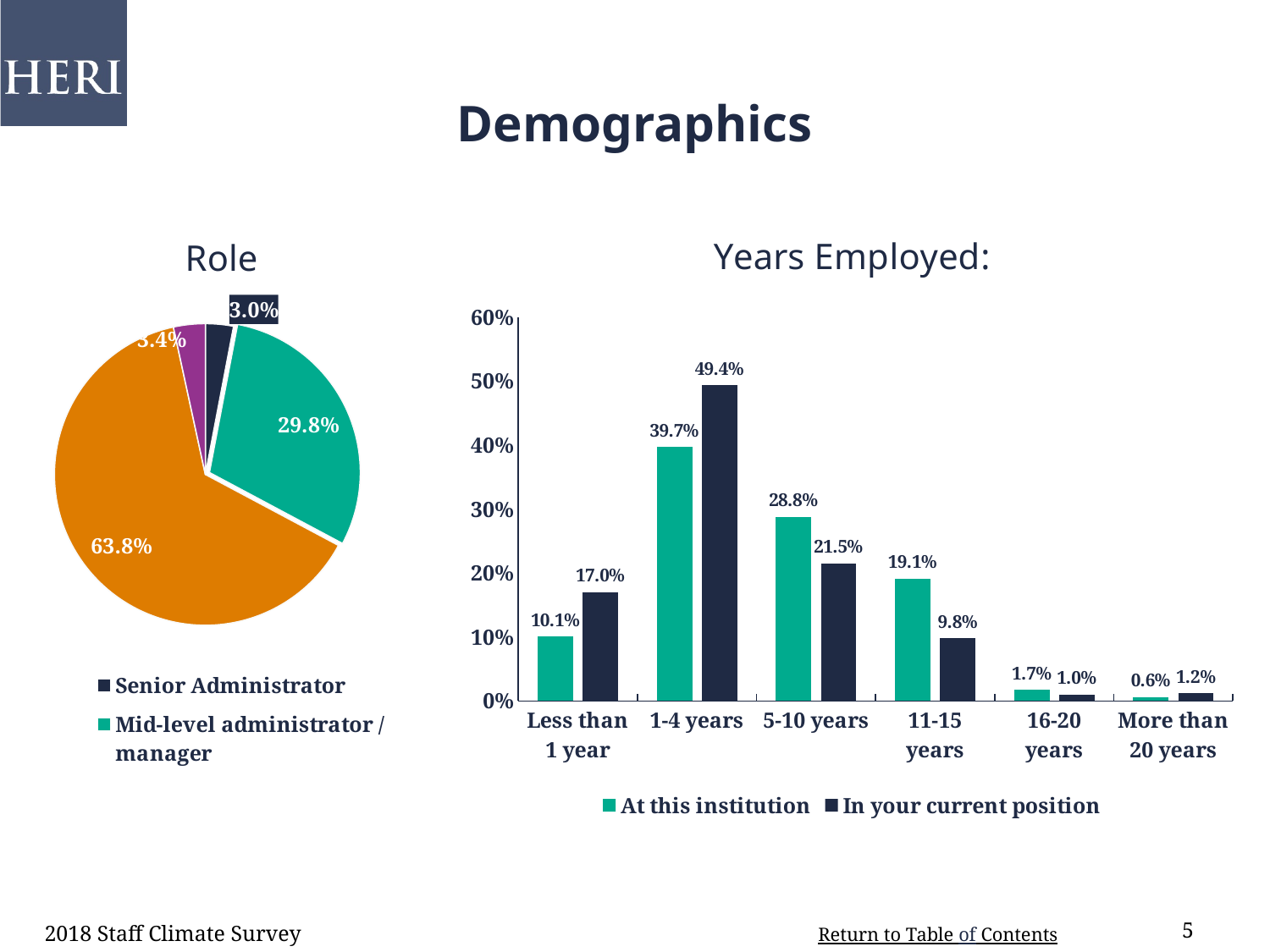
In the Role chart, what share is shown for Mid-level administrator / manager? 29.8% What kind of chart is the Years Employed chart? Bar chart What kind of chart is the Role chart? Pie chart How many categories are shown on the x axis of the Years Employed chart? 6 In the Years Employed chart, for Less than 1 year, which series has the larger value? In your current position How many series does the legend of the Years Employed chart list? 2 In the Years Employed chart, which category has the highest value for In your current position? 1-4 years In the Role chart, what share is shown for Senior Administrator? 3.0% In the Years Employed chart, how much higher is the In your current position value than the At this institution value for 1-4 years? 9.7 percentage points In the Years Employed chart, what percentage is shown for 5-10 years in the In your current position series? 21.5% In the Years Employed chart, what percentage is shown for 1-4 years in the At this institution series? 39.7% In the Years Employed chart, which category has the lowest value for At this institution? More than 20 years